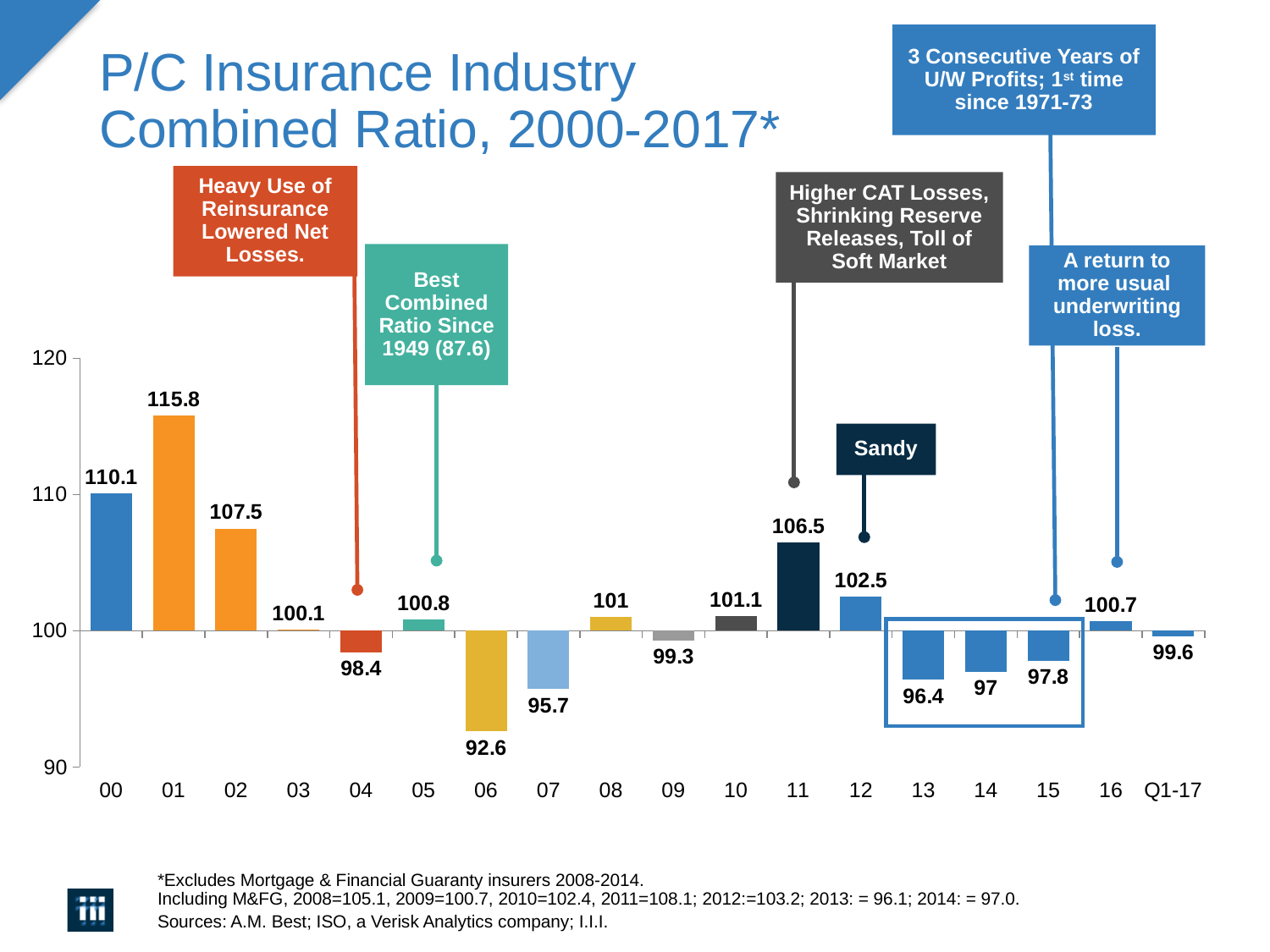
What is the combined ratio shown for 2006? 92.6 Is the value for 2007 greater or less than 100? less Which year has the lowest combined ratio on the chart? 06 Which year has the highest combined ratio on the chart? 01 What is the combined ratio shown for 2001? 115.8 What value is shown for Q1-17? 99.6 According to the callout on the chart, what was the best combined ratio since 1949? 87.6 What kind of chart is shown on the slide? bar chart How many bars are plotted on the chart? 18 Which is larger, the combined ratio for 2000 or for 2002? 2000 Do the values fall or rise from 2013 to 2015? rise What is the difference between the combined ratio for 2011 and for 2012? 4